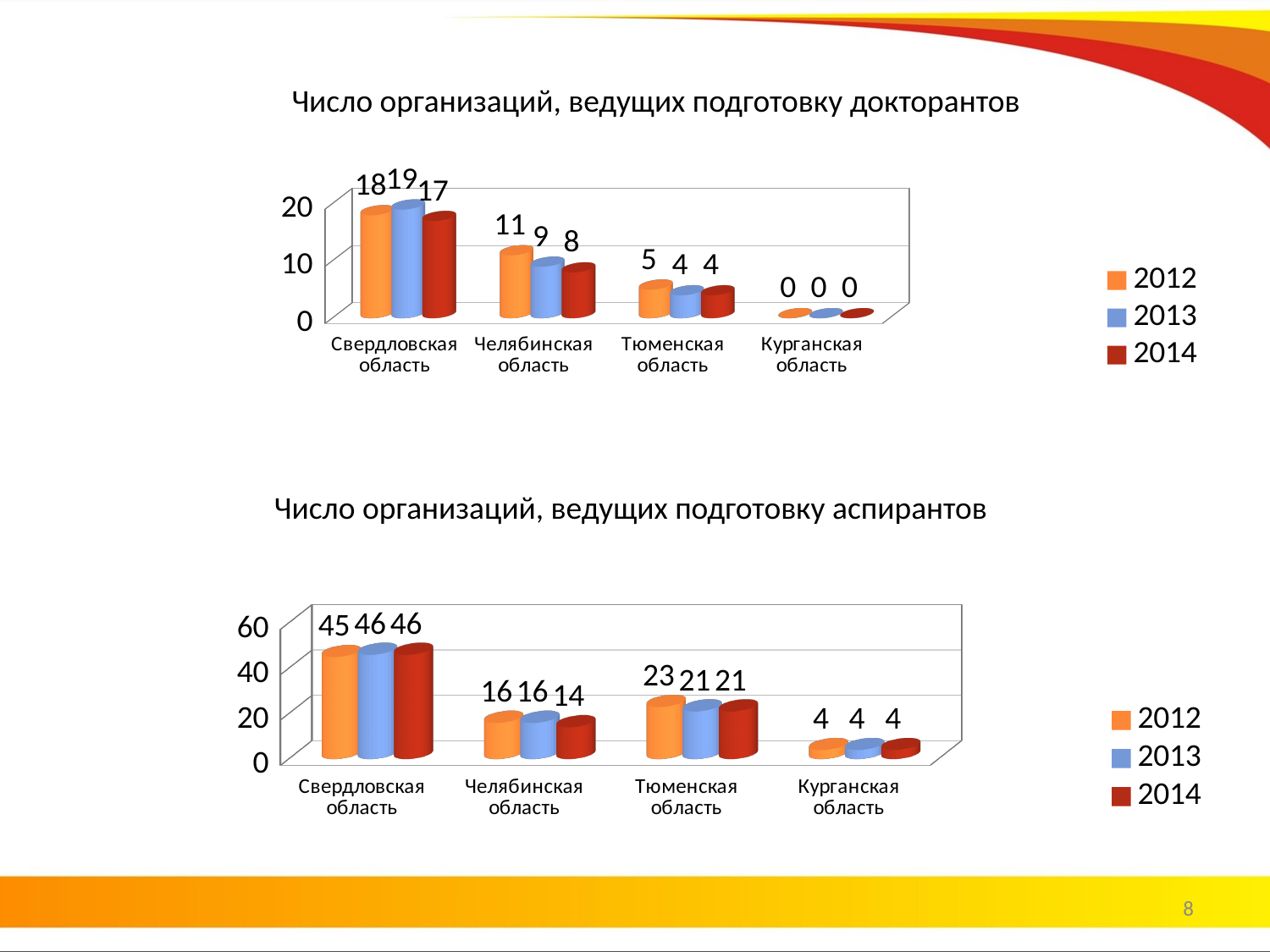
In the top chart (Число организаций, ведущих подготовку докторантов), what is the value for Свердловская область in 2013? 19 In the bottom chart (Число организаций, ведущих подготовку аспирантов), how many regions are shown on the x axis? 4 In the bottom chart (Число организаций, ведущих подготовку аспирантов), which is larger: the 2013 value for Челябинская область or the 2013 value for Тюменская область? Тюменская область In the top chart (Число организаций, ведущих подготовку докторантов), which region has the highest value in 2012? Свердловская область In the top chart (Число организаций, ведущих подготовку докторантов), which region has the lowest value in 2014? Курганская область In the top chart (Число организаций, ведущих подготовку докторантов), what is the value for Челябинская область in 2014? 8 What kind of chart is the bottom chart (Число организаций, ведущих подготовку аспирантов)? Bar chart In the bottom chart (Число организаций, ведущих подготовку аспирантов), what is the value for Курганская область in 2014? 4 In the bottom chart (Число организаций, ведущих подготовку аспирантов), what is the value for Тюменская область in 2012? 23 In the top chart (Число организаций, ведущих подготовку докторантов), what is the difference between the 2012 and 2014 values for Челябинская область? 3 In the top chart (Число организаций, ведущих подготовку докторантов), how many series does the legend list? 3 In the bottom chart (Число организаций, ведущих подготовку аспирантов), what is the difference between the 2014 values for Свердловская область and Тюменская область? 25